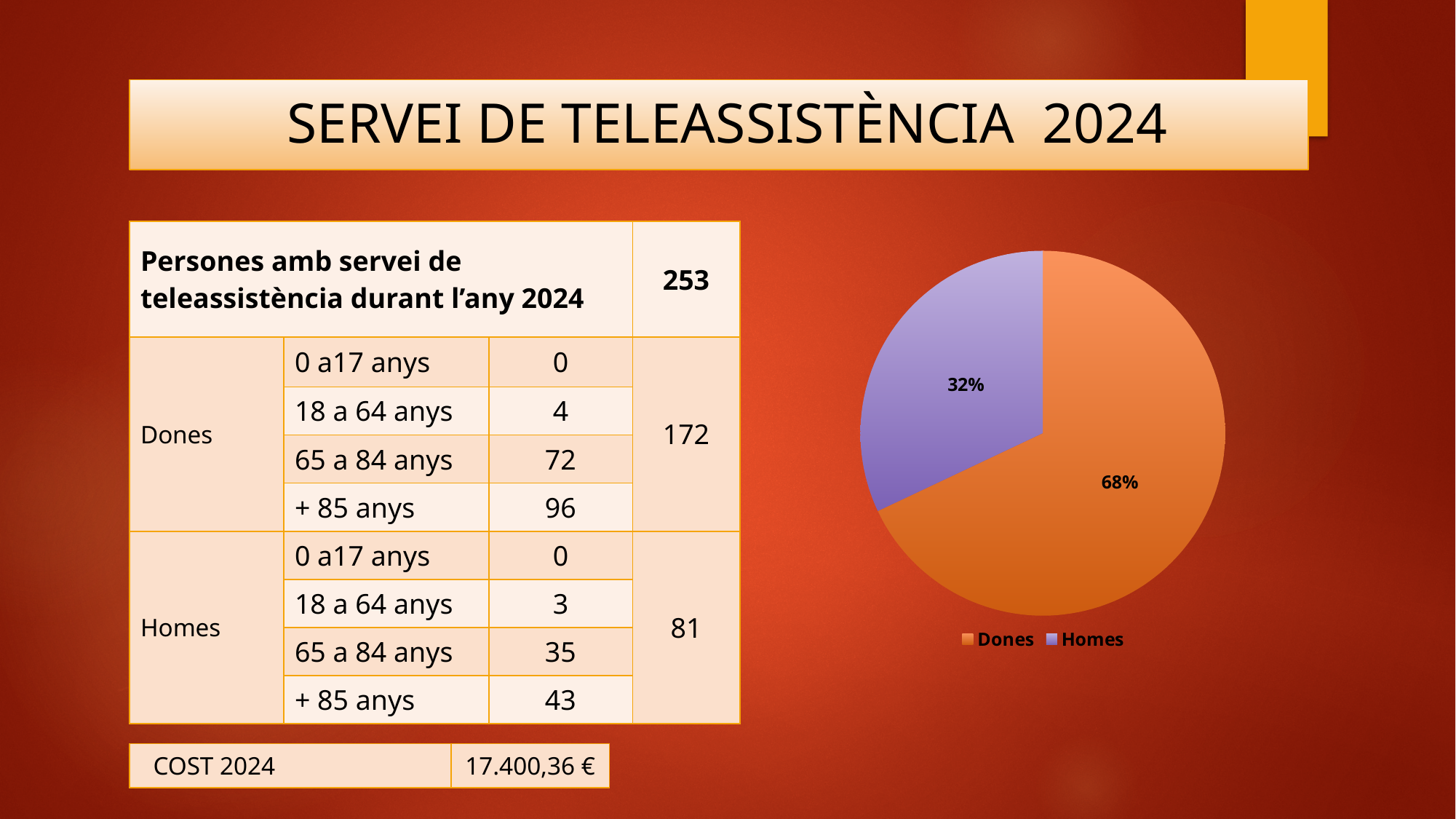
What is the difference in percentage points between the Dones and Homes slices of the pie chart? 36 In the pie chart, which is larger, Dones or Homes? Dones What colour is the Homes slice in the pie chart? purple What share of the pie chart does Homes represent? 32% How many entries does the pie chart's legend list? 2 What colour is the Dones slice in the pie chart? orange What kind of chart is shown on the slide? pie chart How many slices does the pie chart have? 2 Which slice of the pie chart is the largest? Dones Which slice of the pie chart is the smallest? Homes What share of the pie chart does Dones represent? 68%